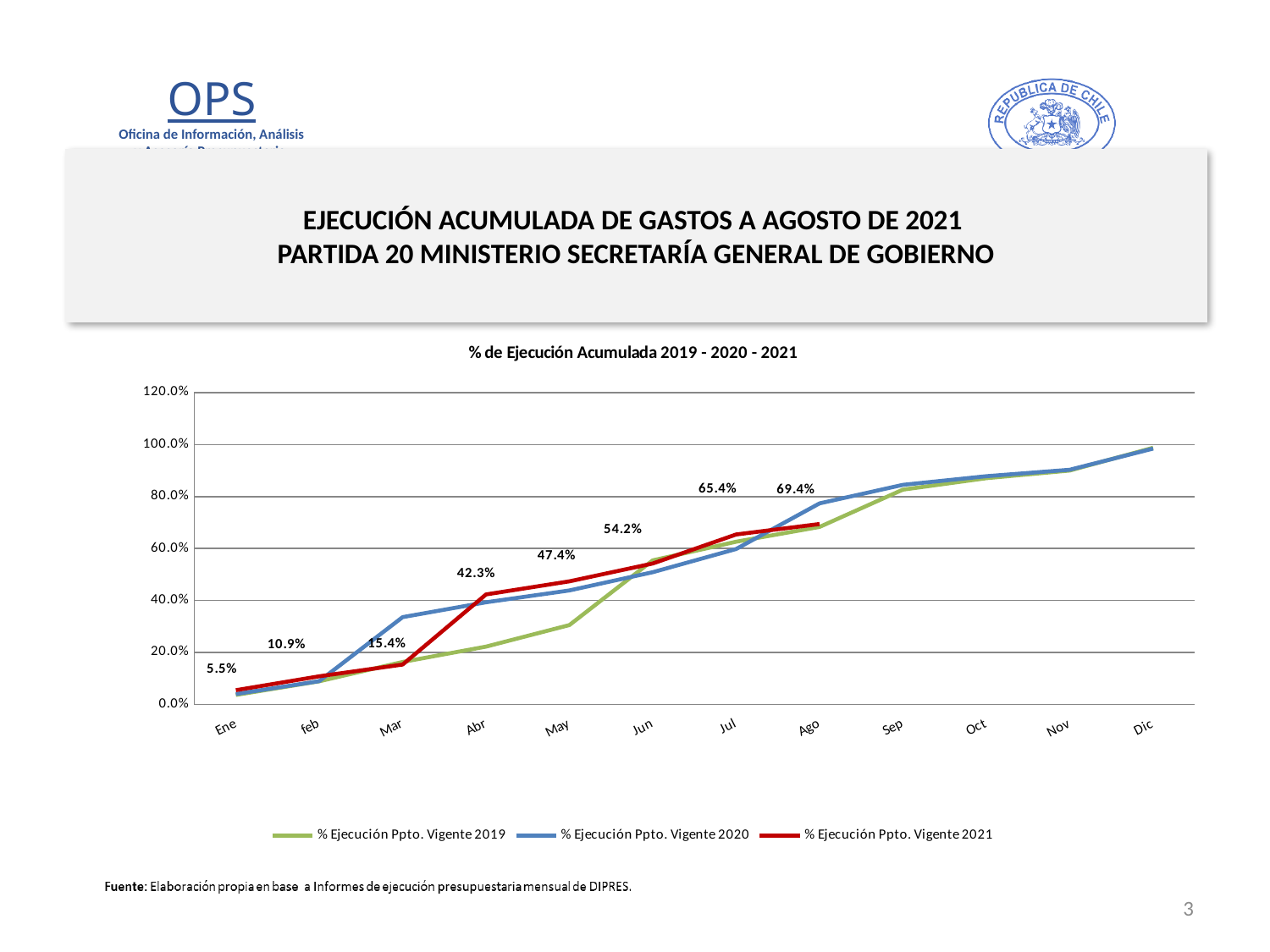
Does the % Ejecución Ppto. Vigente 2021 line rise or fall from Ene to Ago? rise What is the title of the chart? % de Ejecución Acumulada 2019 - 2020 - 2021 How many months are shown on the x axis? 12 Is the value of % Ejecución Ppto. Vigente 2020 for Dic greater or less than 80.0%? greater What is the difference between the 2021 values for Ago and Jul? 4.0% What is the value of % Ejecución Ppto. Vigente 2021 for Abr? 42.3% Which is larger in Mar: % Ejecución Ppto. Vigente 2020 or % Ejecución Ppto. Vigente 2021? % Ejecución Ppto. Vigente 2020 What is the value of % Ejecución Ppto. Vigente 2021 for Ene? 5.5% What is the difference between the 2021 values for Abr and Mar? 26.9% What is the value of % Ejecución Ppto. Vigente 2021 for Ago? 69.4% What kind of chart is shown on the slide? line chart How many series does the legend list? 3